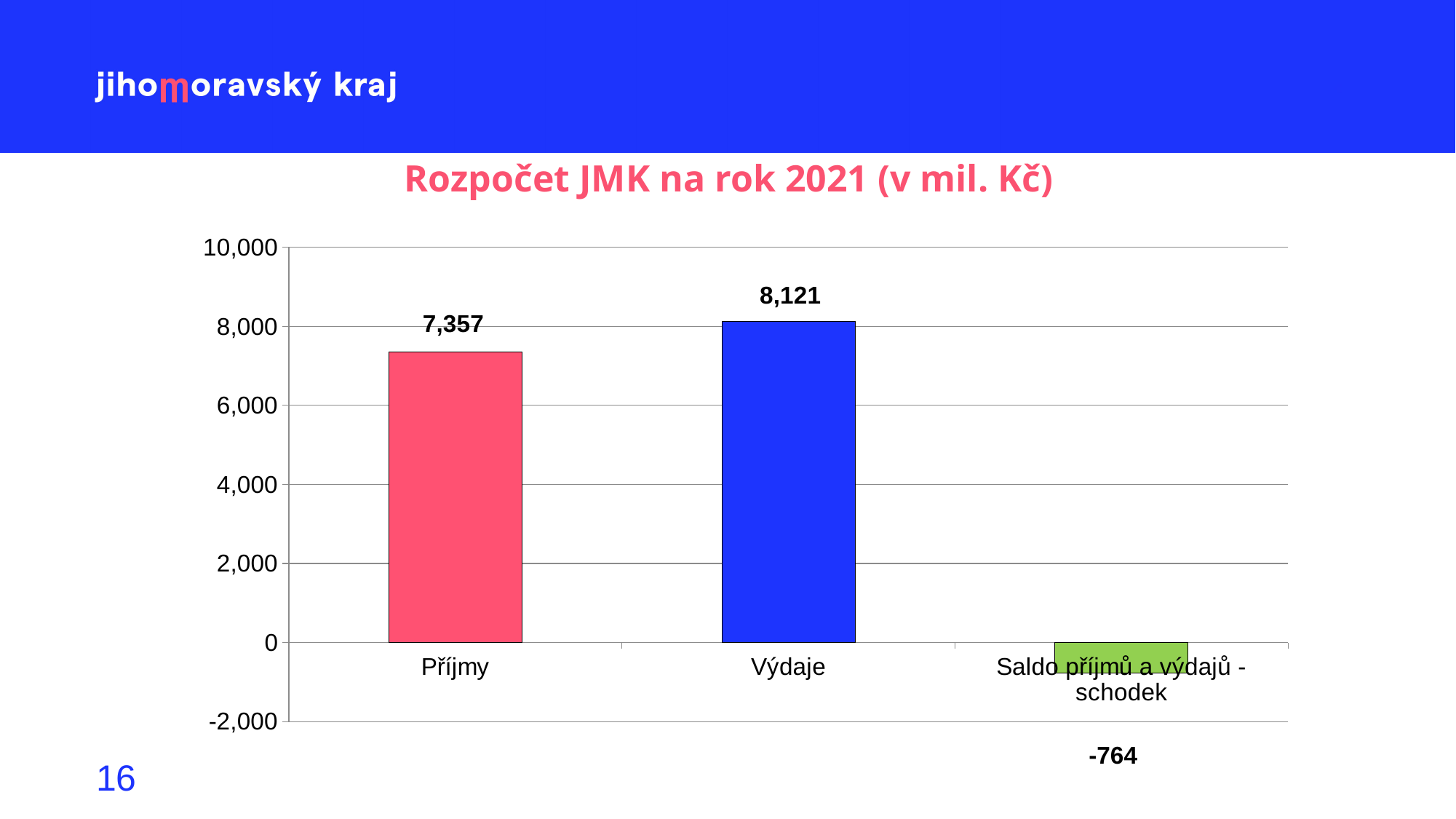
Is the value for Příjmy greater or less than 8,000? less What is the difference between Výdaje and Příjmy? 764 Which is larger, Příjmy or Výdaje? Výdaje What is the value for Příjmy? 7,357 What is the title of the chart? Rozpočet JMK na rok 2021 (v mil. Kč) What is the value for Výdaje? 8,121 What is the value for Saldo příjmů a výdajů - schodek? -764 Which category has the lowest value? Saldo příjmů a výdajů - schodek What kind of chart is shown on the slide? bar chart Which category has the highest value? Výdaje What colour is the bar for Výdaje? blue How many categories are shown on the chart? 3